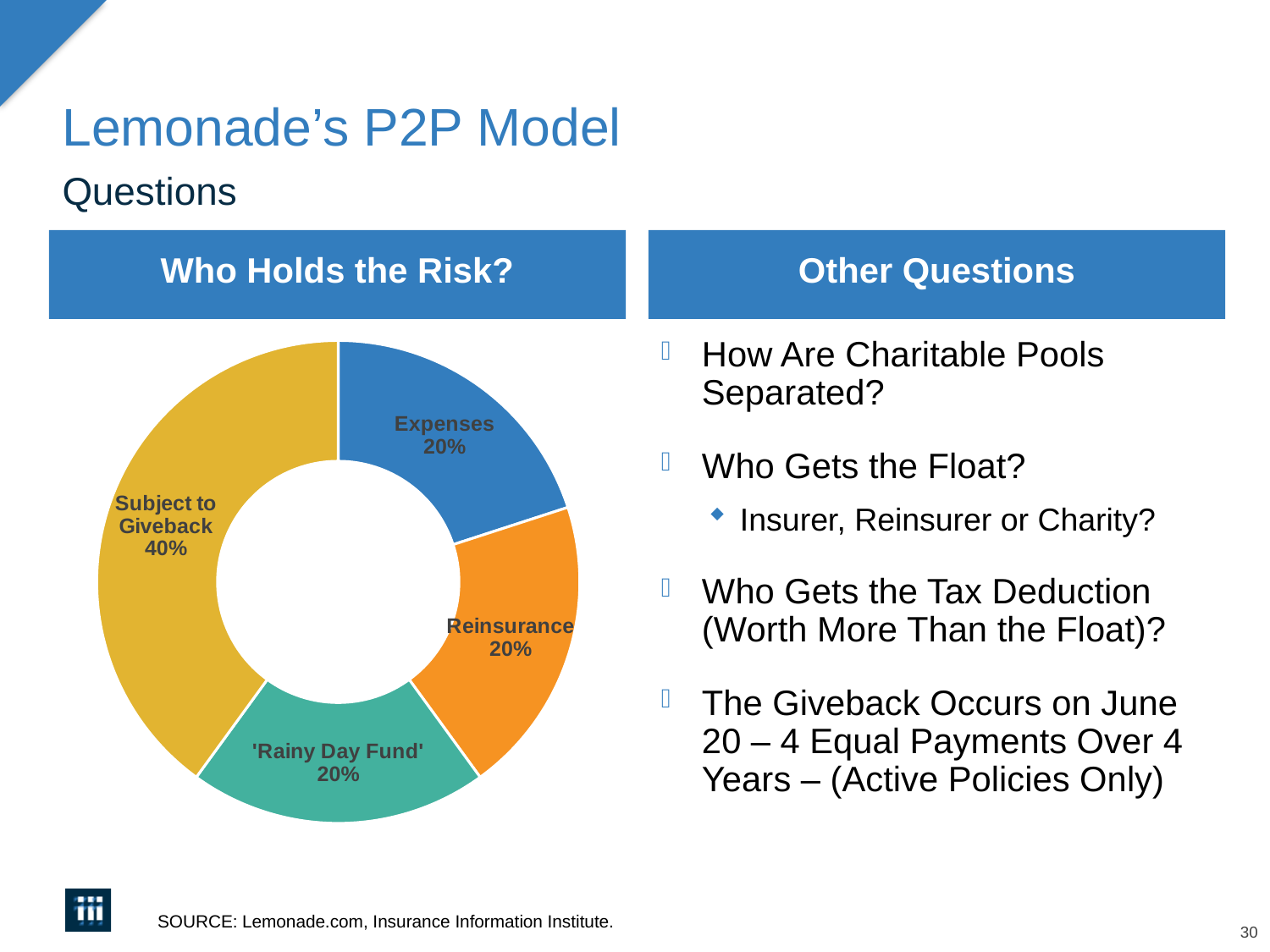
What is the title of the chart? Who Holds the Risk? What is the value shown for Expenses? 20% What kind of chart is shown on the slide? Pie chart (doughnut) What colour is the Subject to Giveback slice? Yellow What is the difference between the share for Subject to Giveback and the share for Expenses? 20% How many categories are shown in the chart? 4 Which is larger, the share for Subject to Giveback or the share for Reinsurance? Subject to Giveback Which category has the largest share of the chart? Subject to Giveback What is the combined share of Expenses, Reinsurance and 'Rainy Day Fund'? 60% What is the value shown for 'Rainy Day Fund'? 20% What share of the pie does 'Subject to Giveback' represent? 40% What is the value shown for Reinsurance? 20%